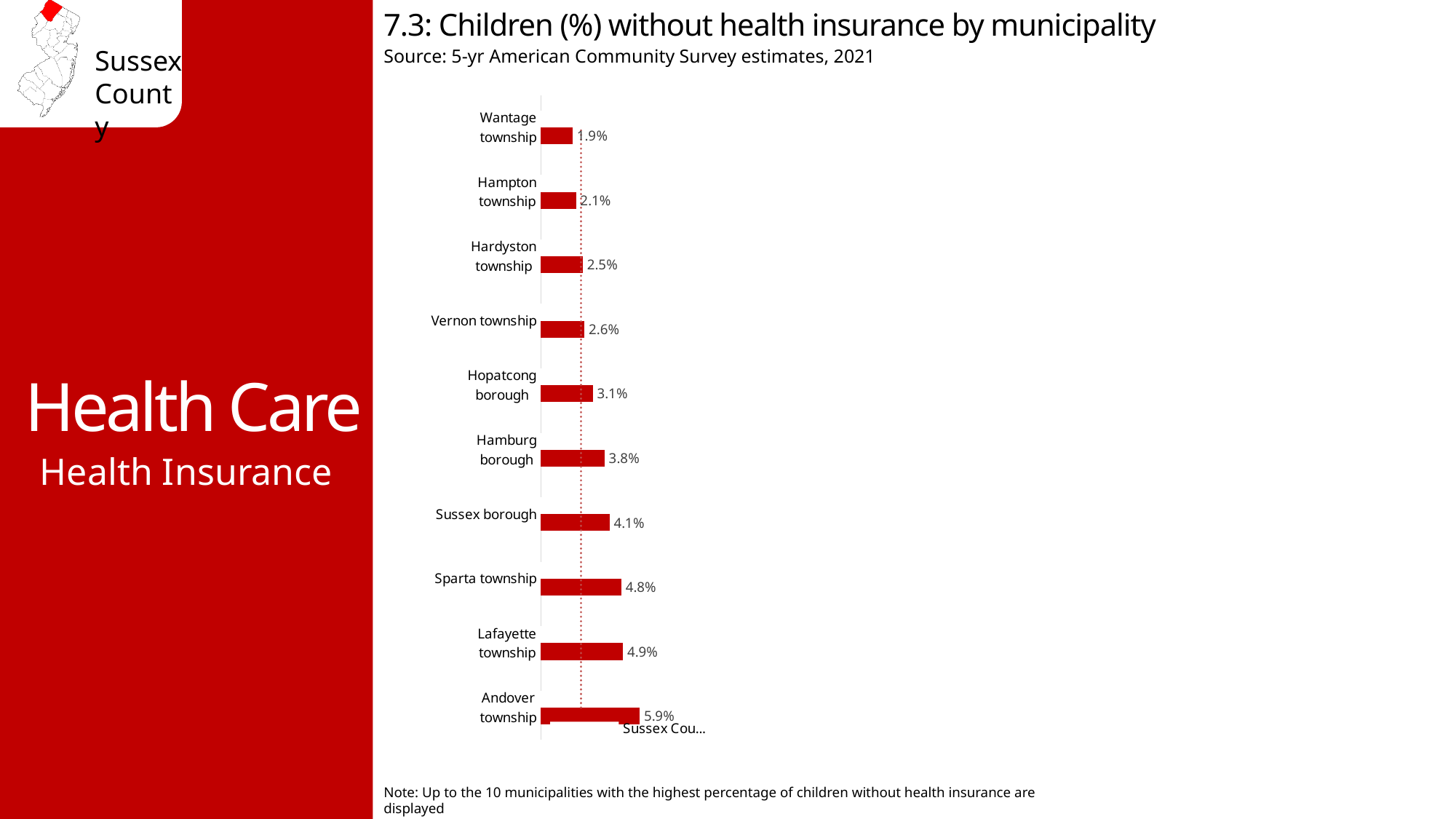
What is the source of the data shown in the chart? 5-yr American Community Survey estimates, 2021 What percentage of children are without health insurance in Andover township? 5.9% What is the difference between the values for Sussex borough and Hamburg borough? 0.3% What is the value shown for Hopatcong borough? 3.1% Which municipality has the highest percentage of children without health insurance? Andover township Which has a higher value, Lafayette township or Vernon township? Lafayette township What percentage is shown for Sparta township? 4.8% What kind of chart is used on this slide? Bar chart Which has a lower value, Hampton township or Hardyston township? Hampton township Which municipality has the lowest percentage of children without health insurance? Wantage township How many municipalities are shown in the chart? 10 What is the difference between the values for Andover township and Wantage township? 4.0%